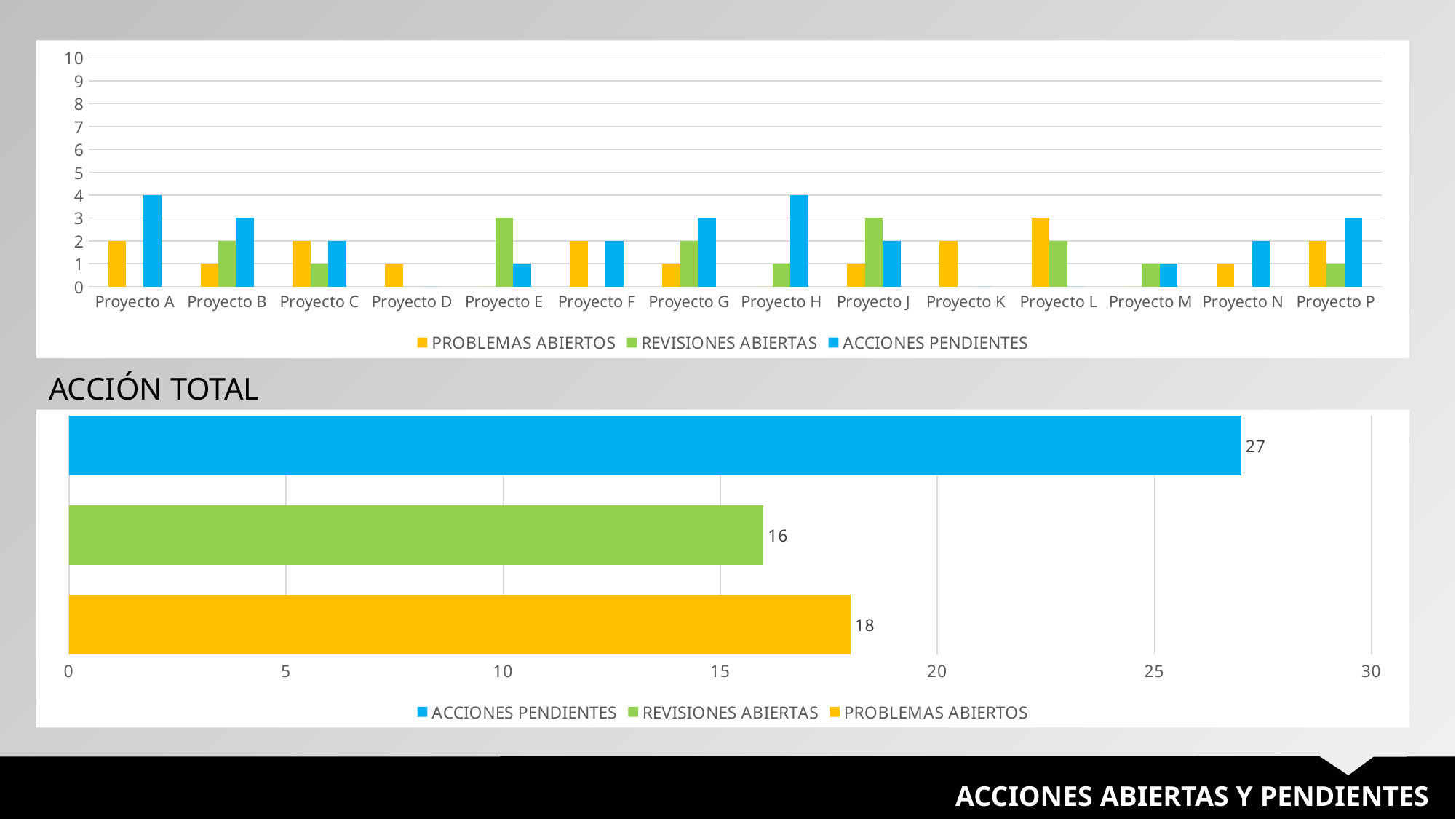
In the ACCIÓN TOTAL chart, which series has the highest value? ACCIONES PENDIENTES How many series does the legend of the top chart list? 3 In the ACCIÓN TOTAL chart, which series has the lowest value? REVISIONES ABIERTAS In the ACCIÓN TOTAL chart, what is the value for ACCIONES PENDIENTES? 27 How many projects are shown on the x axis of the top chart? 14 In the ACCIÓN TOTAL chart, what is the difference between ACCIONES PENDIENTES and PROBLEMAS ABIERTOS? 9 In the top chart, what is the value of ACCIONES PENDIENTES for Proyecto A? 4 In the ACCIÓN TOTAL chart, which is larger: PROBLEMAS ABIERTOS or REVISIONES ABIERTAS? PROBLEMAS ABIERTOS In the top chart, is the value of ACCIONES PENDIENTES for Proyecto H greater or less than 3? greater In the ACCIÓN TOTAL chart, what is the value for REVISIONES ABIERTAS? 16 What kind of chart is the ACCIÓN TOTAL chart? Bar chart In the top chart, what is the value of REVISIONES ABIERTAS for Proyecto E? 3